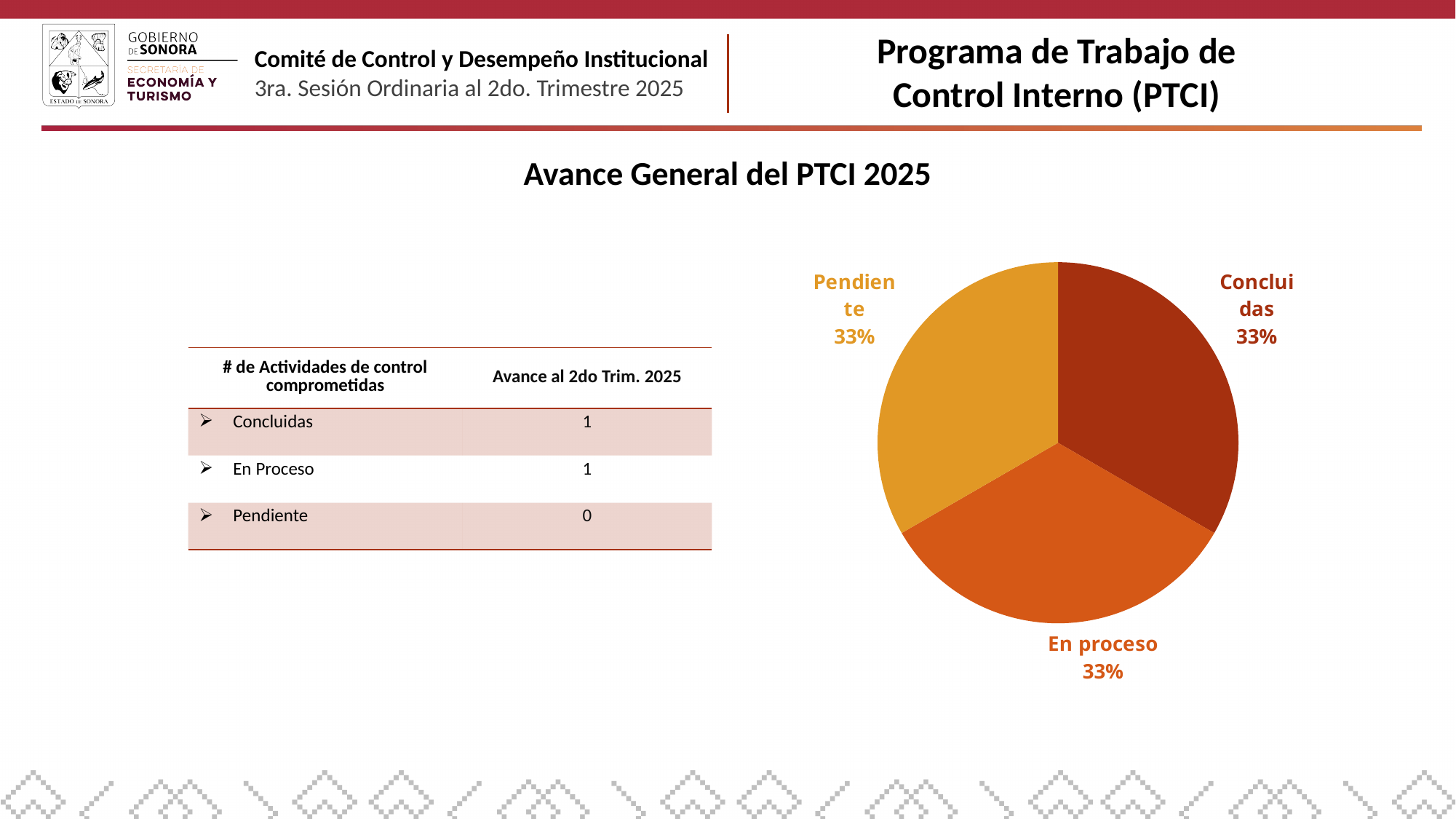
What percentage is labelled on the Pendiente slice of the pie chart? 33% What share of the pie chart does the Concluidas slice represent? 33% How many slices does the pie chart have? 3 What colour is the Pendiente slice of the pie chart? Yellow-orange Is the share of the Concluidas slice greater or less than 25%? greater What share of the pie chart does the Pendiente slice represent? 33% What kind of chart is shown on the slide? Pie chart What colour is the Concluidas slice of the pie chart? Dark red-brown What share of the pie chart does the En proceso slice represent? 33% Is the share of the En proceso slice greater or less than 50%? less What percentage is labelled on the Concluidas slice of the pie chart? 33%